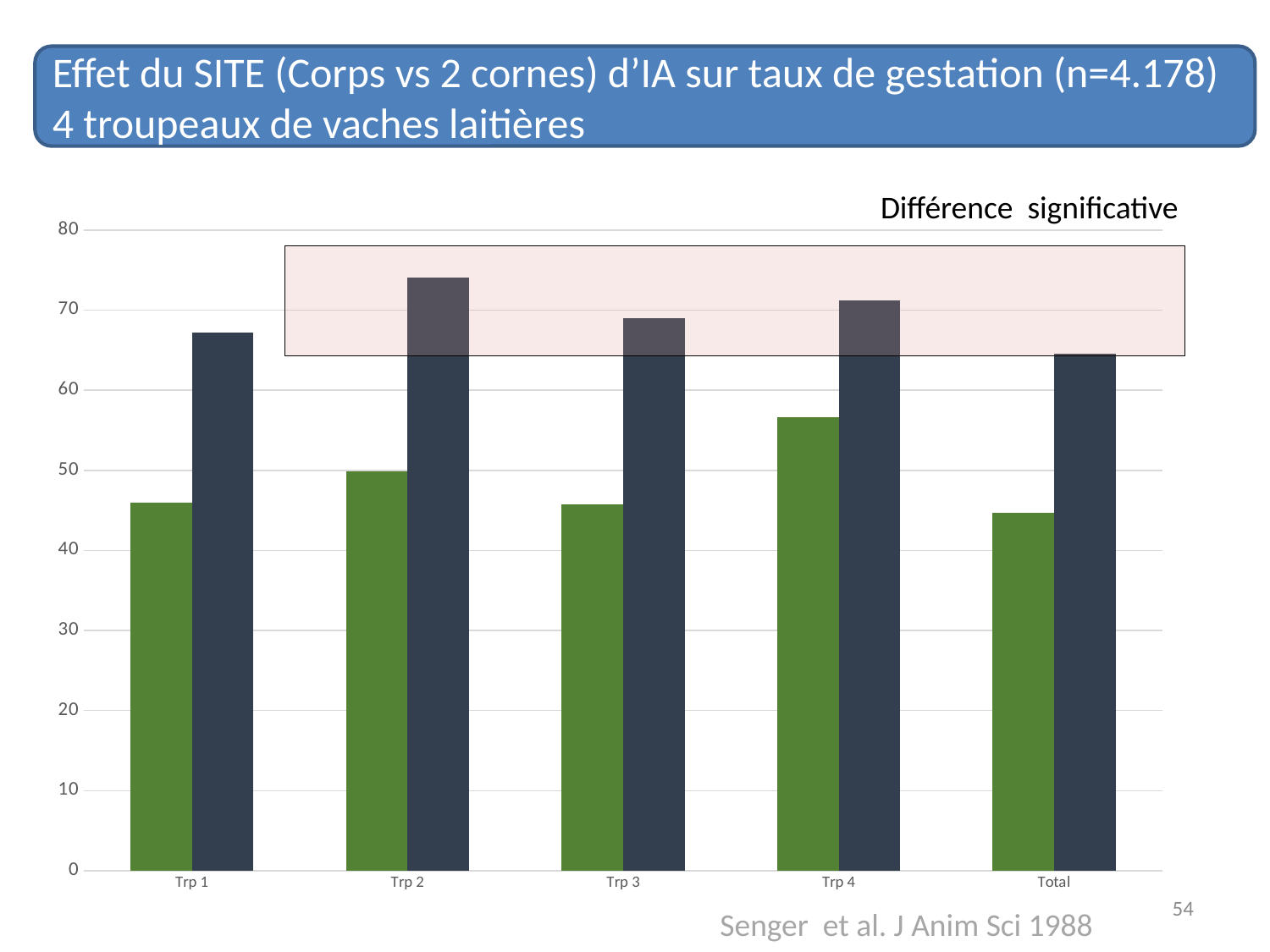
Is the value of the dark blue bar for Total greater or less than 70? less Which category has the highest green bar? Trp 4 Is the value of the dark blue bar for Trp 2 greater or less than 70? greater What kind of chart is shown on the slide? bar chart For Trp 3, which bar is taller, the green bar or the dark blue bar? the dark blue bar What is the label of the last category on the x axis? Total How many categories are shown on the x axis of the chart? 5 Which category has the highest dark blue bar? Trp 2 Is the value of the green bar for Trp 1 greater or less than 50? less How many bars are plotted for each category on the chart? 2